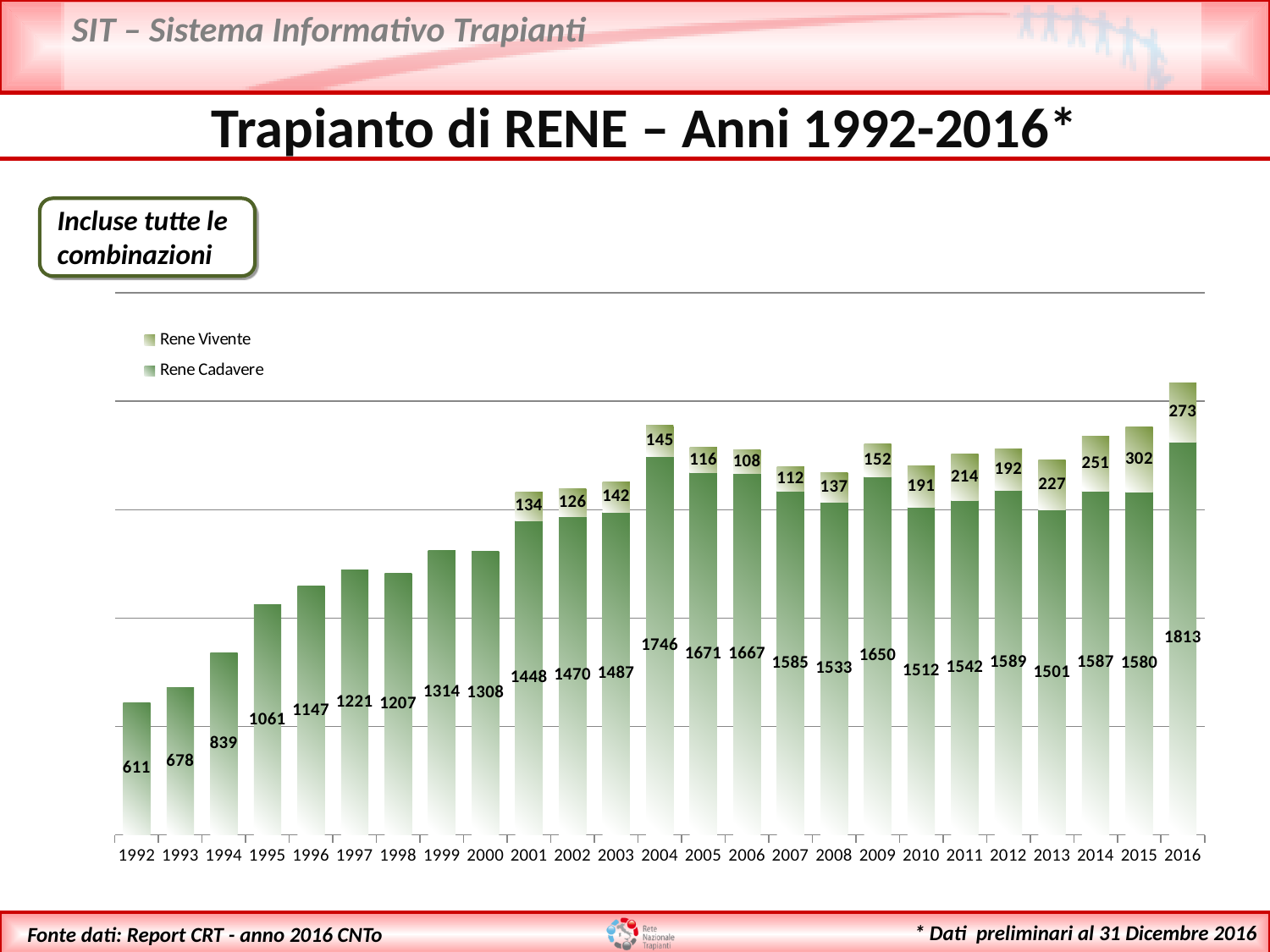
What is the difference between the Rene Cadavere values for 2016 and 2015? 233 What is the total of the stacked bar for 2016? 2086 How many series does the legend list? 2 Which year has the highest Rene Cadavere value? 2016 What is the Rene Cadavere value for 2016? 1813 What is the Rene Vivente value for 2015? 302 Which is larger, the Rene Cadavere value for 2004 or for 2005? 2004 Which year has the lowest Rene Cadavere value? 1992 What kind of chart is shown on the slide? Stacked bar chart Which year has the highest Rene Vivente value? 2015 How many years are shown on the x axis? 25 What is the Rene Cadavere value for 1992? 611